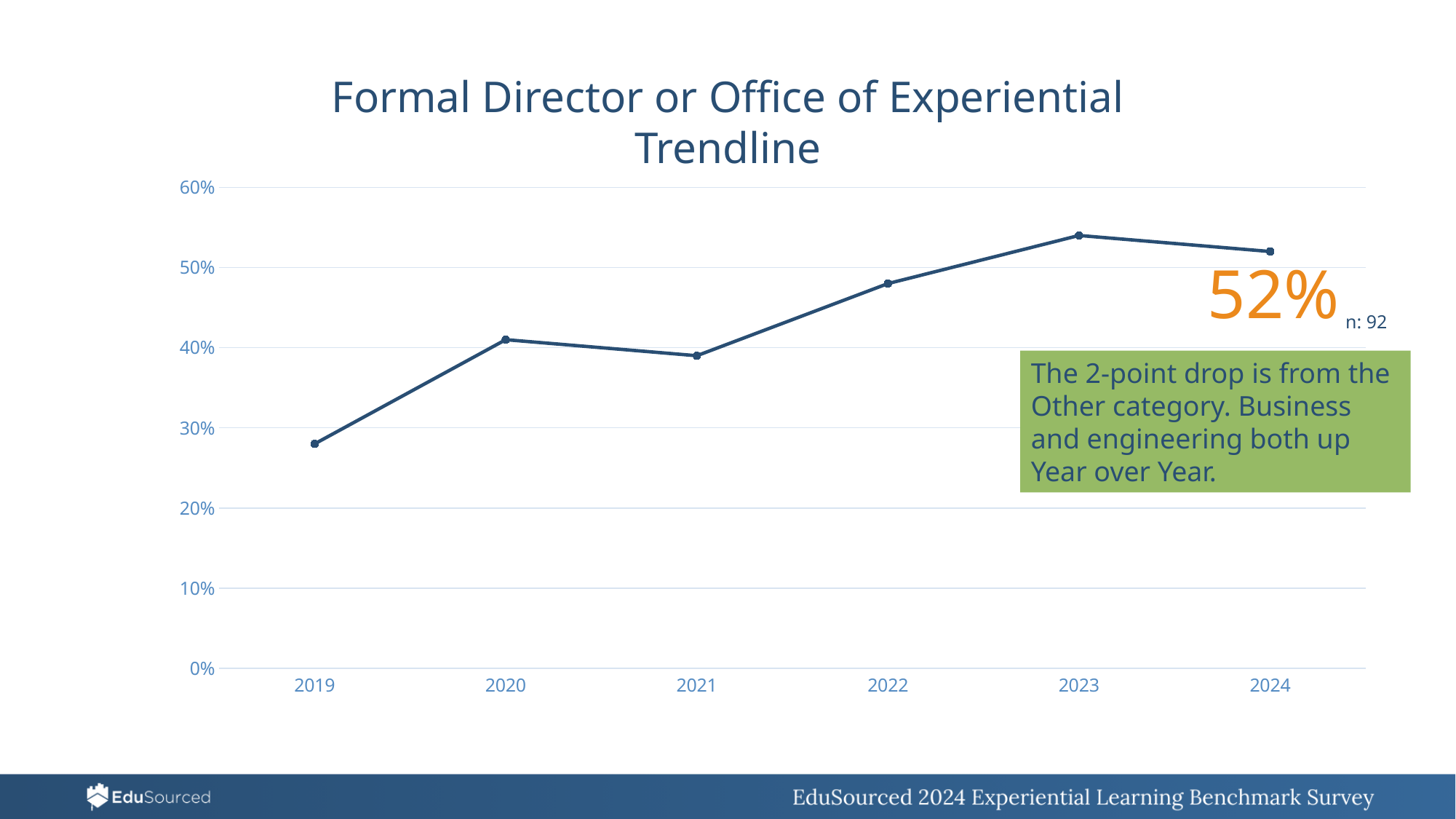
Is the value for 2023 greater or less than 50%? greater Does the value rise or fall from 2019 to 2020? rise Which is larger, the value for 2022 or the value for 2020? 2022 Is the value for 2022 greater or less than 50%? less Is the value for 2019 greater or less than 30%? less How many years are plotted on the x axis? 6 Which year has the lowest value? 2019 Does the value rise or fall from 2023 to 2024? fall What is the title of the chart? Formal Director or Office of Experiential Trendline Which year has the highest value? 2023 What type of chart is shown on the slide? line chart What is the value for 2024? 52%